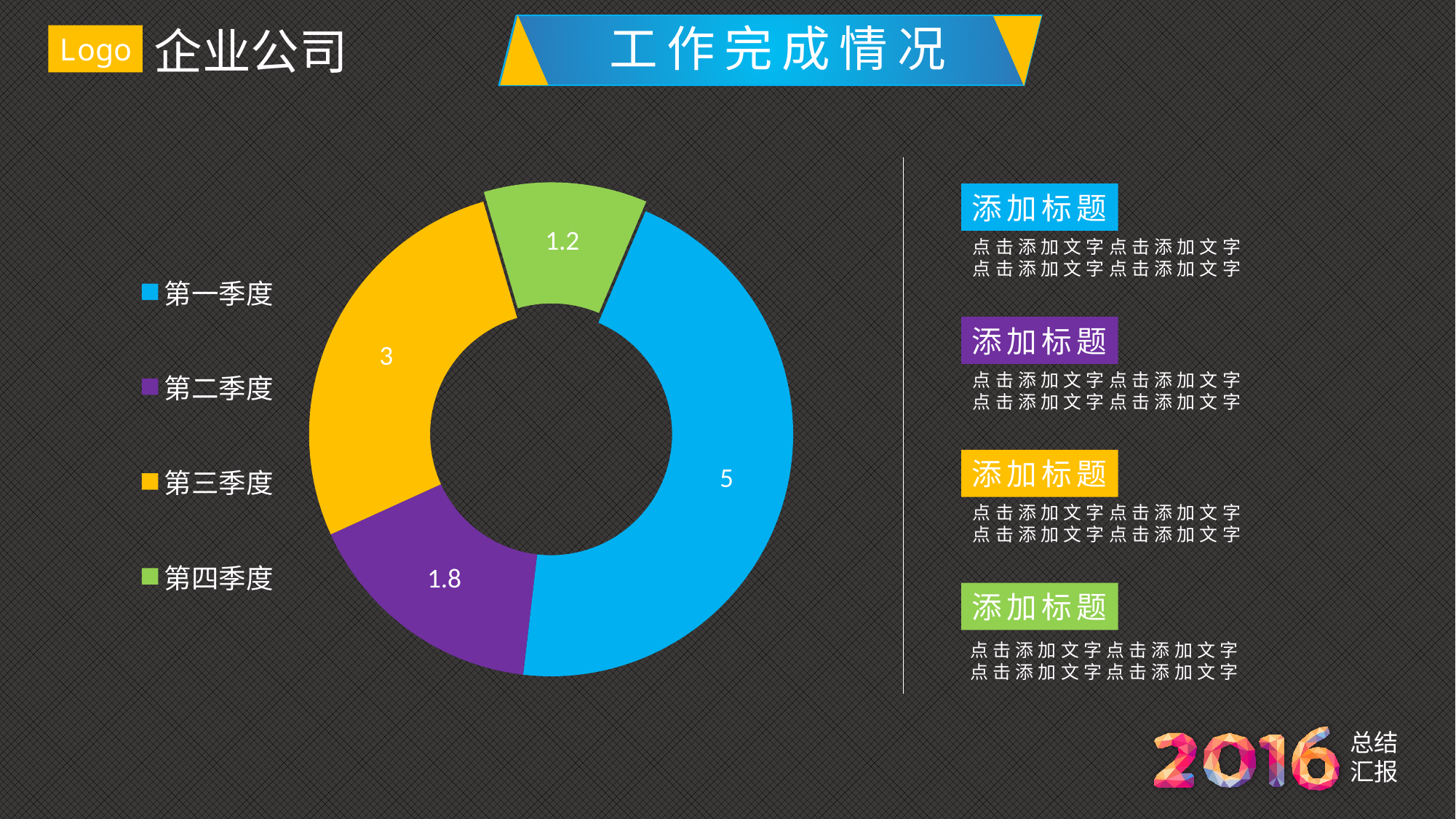
Which is larger, the value for 第三季度 or the value for 第二季度? 第三季度 What is the value for 第二季度 in the doughnut chart? 1.8 What is the difference between the values for 第一季度 and 第三季度? 2 What kind of chart is shown on the slide? doughnut chart What is the difference between the values for 第二季度 and 第四季度? 0.6 What is the value for 第四季度 in the doughnut chart? 1.2 Which category has the lowest value in the doughnut chart? 第四季度 How many categories are shown in the doughnut chart? 4 Which category has the highest value in the doughnut chart? 第一季度 What is the value for 第一季度 in the doughnut chart? 5 What is the value for 第三季度 in the doughnut chart? 3 What colour represents 第三季度 in the chart legend? yellow